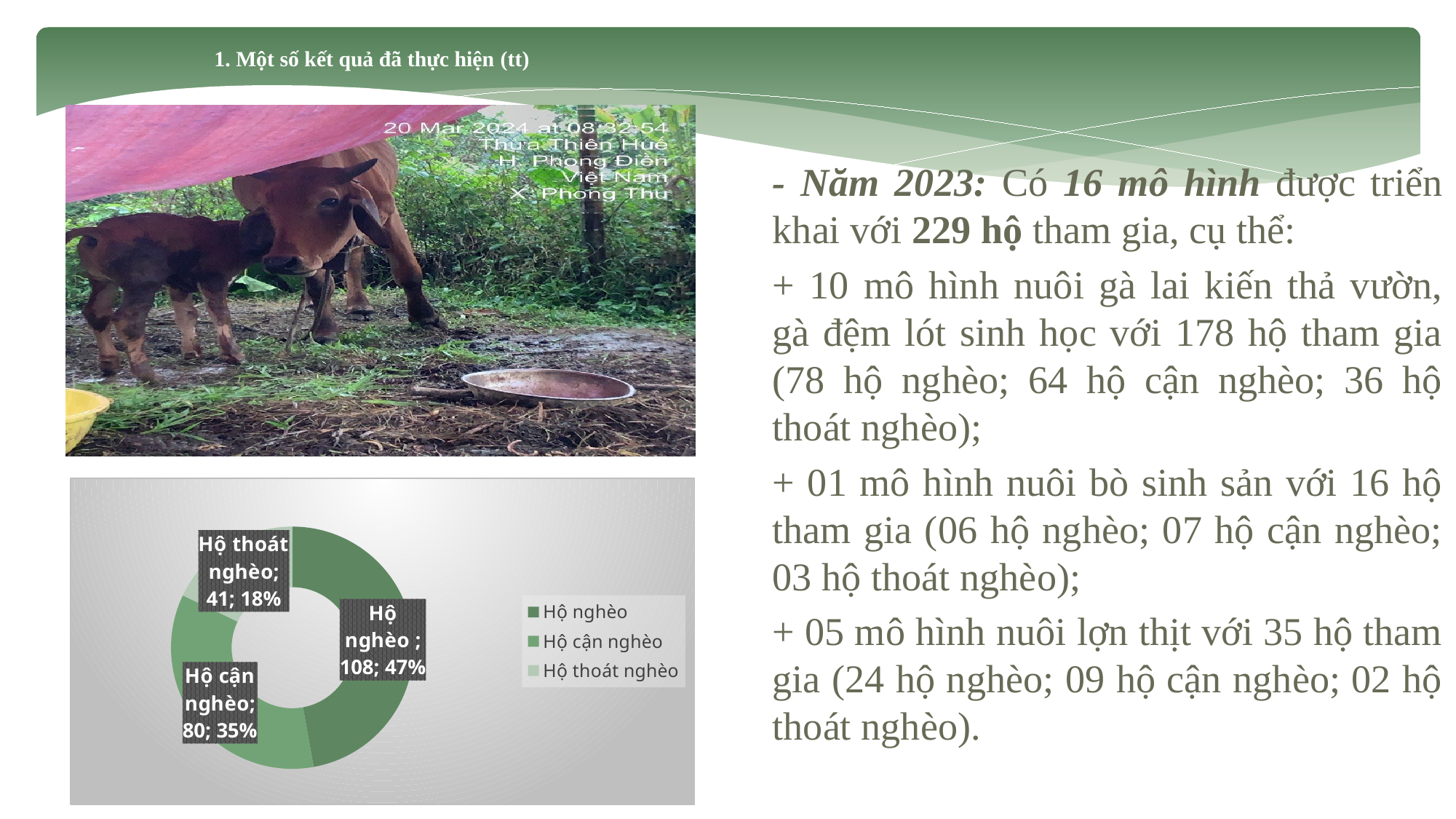
What is the difference between the values for Hộ nghèo and Hộ cận nghèo in the doughnut chart? 28 Which is larger in the doughnut chart, Hộ cận nghèo or Hộ thoát nghèo? Hộ cận nghèo How many slices does the doughnut chart have? 3 What kind of chart is shown on the slide? Doughnut (pie) chart What is the value shown for Hộ thoát nghèo in the doughnut chart? 41 What share of the doughnut chart does Hộ thoát nghèo represent? 18% How many entries does the legend of the doughnut chart list? 3 Which category has the smallest slice in the doughnut chart? Hộ thoát nghèo What is the value shown for Hộ nghèo in the doughnut chart? 108 What is the value shown for Hộ cận nghèo in the doughnut chart? 80 Which category has the largest slice in the doughnut chart? Hộ nghèo What share of the doughnut chart does Hộ nghèo represent? 47%